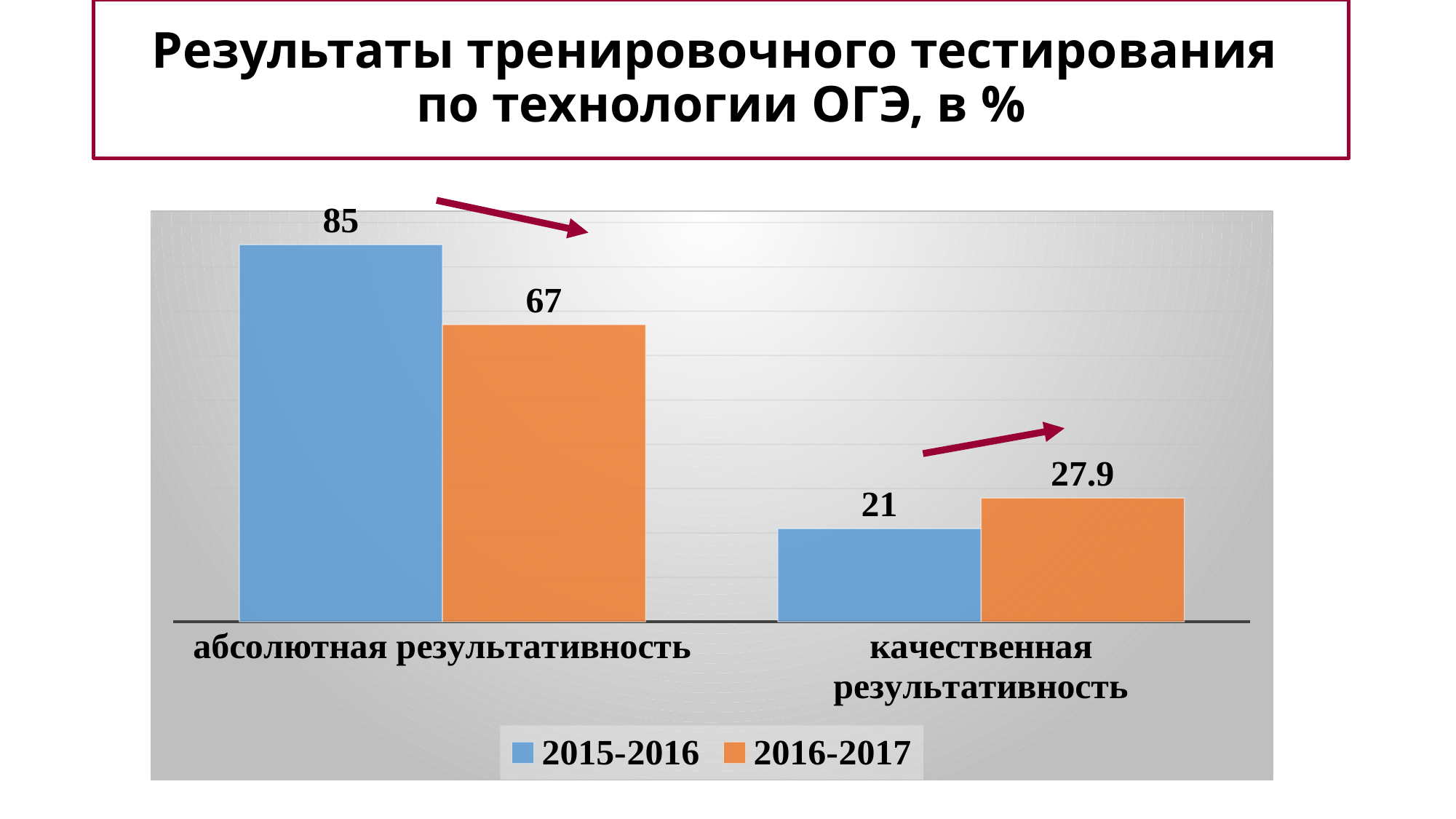
What is the value for 2016-2017 in the качественная результативность category? 27.9 Which bar has the lowest value on the chart? 2015-2016, качественная результативность What is the value for 2015-2016 in the абсолютная результативность category? 85 What is the difference between the 2015-2016 and 2016-2017 values for абсолютная результативность? 18 What is the value for 2015-2016 in the качественная результативность category? 21 Which bar has the highest value on the chart? 2015-2016, абсолютная результативность Which series has the higher value for качественная результативность? 2016-2017 What is the difference between the 2016-2017 and 2015-2016 values for качественная результативность? 6.9 How many series does the legend list? 2 What kind of chart is shown on the slide? Bar chart Which series has the higher value for абсолютная результативность? 2015-2016 What is the value for 2016-2017 in the абсолютная результативность category? 67